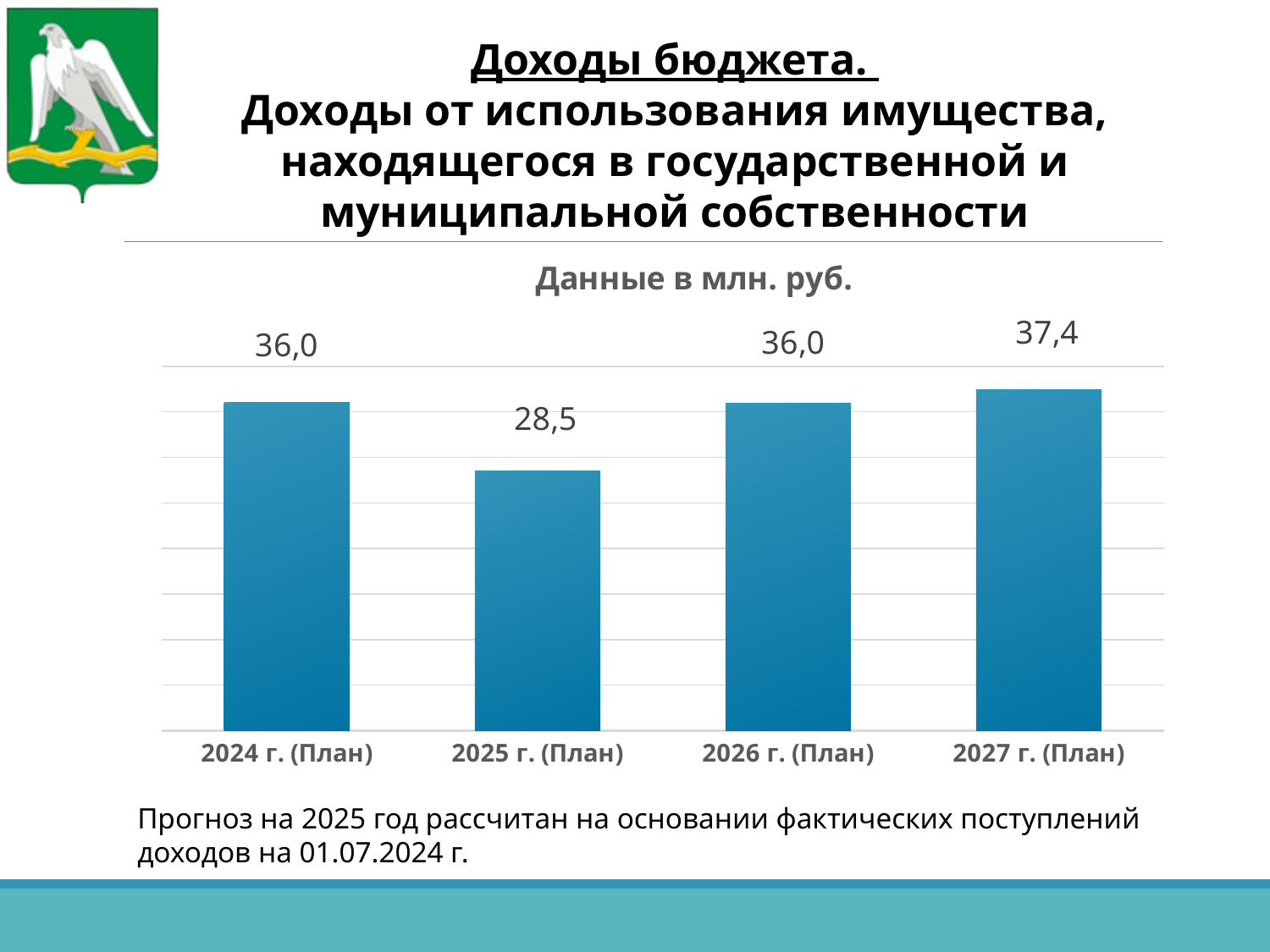
Which category has the lowest value? 2025 г. (План) What is the value for 2025 г. (План)? 28,5 How many categories are shown on the chart? 4 What is the value for 2024 г. (План)? 36,0 What is the value for 2027 г. (План)? 37,4 What kind of chart is shown on the slide? bar chart Do the values rise or fall from 2025 г. (План) to 2027 г. (План)? rise What is the title of the chart? Данные в млн. руб. Which category has the highest value? 2027 г. (План) What is the difference between the values for 2024 г. (План) and 2025 г. (План)? 7,5 What is the difference between the values for 2027 г. (План) and 2026 г. (План)? 1,4 Which is larger, the value for 2025 г. (План) or the value for 2026 г. (План)? 2026 г. (План)